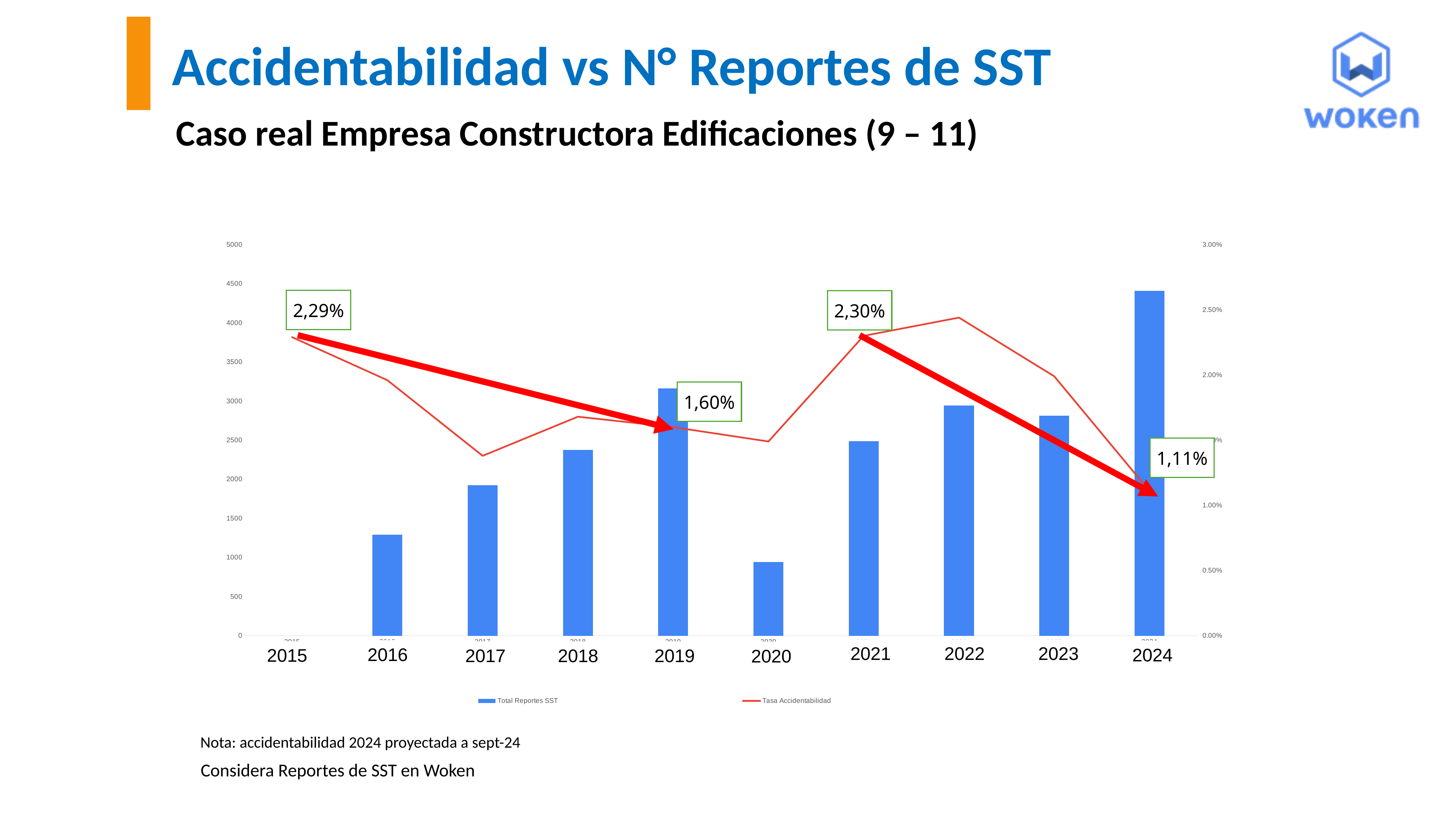
Is the Total Reportes SST bar for 2024 greater or less than 4000? greater What is the Tasa Accidentabilidad value labelled for 2024? 1,11% What is the difference between the labelled Tasa Accidentabilidad values for 2015 and 2024? 1,18% What is the Tasa Accidentabilidad value labelled for 2019? 1,60% What is the Tasa Accidentabilidad value labelled for 2021? 2,30% What is the Tasa Accidentabilidad value labelled for 2015? 2,29% Which year has the tallest Total Reportes SST bar? 2024 Which year has the larger Total Reportes SST bar, 2019 or 2021? 2019 How many years are shown on the x axis of the chart? 10 Does the Tasa Accidentabilidad line rise or fall from 2021 to 2024? fall How many series does the chart legend list? 2